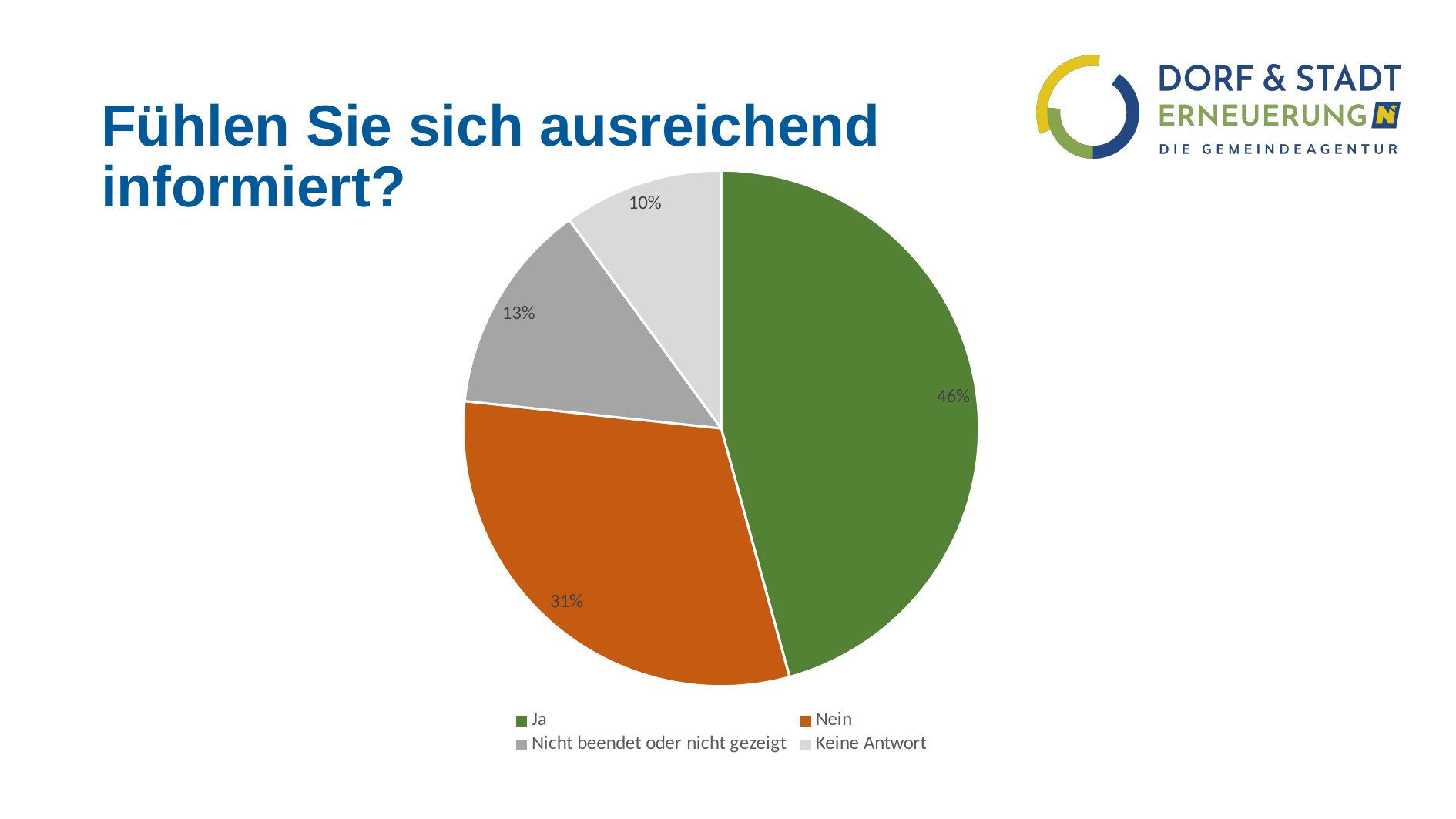
What share of the pie is labelled "Ja"? 46% What kind of chart is shown on the slide? pie chart How many categories does the pie chart have? 4 Which slice is larger, "Nicht beendet oder nicht gezeigt" or "Keine Antwort"? Nicht beendet oder nicht gezeigt What question is shown as the slide title above the chart? Fühlen Sie sich ausreichend informiert? Which category has the smallest slice of the pie? Keine Antwort What share of the pie is labelled "Nicht beendet oder nicht gezeigt"? 13% What share of the pie is labelled "Keine Antwort"? 10% What is the difference in percentage points between the "Ja" and "Nein" slices? 15 What share of the pie is labelled "Nein"? 31% Which category has the largest slice of the pie? Ja What colour is the "Nein" slice? orange